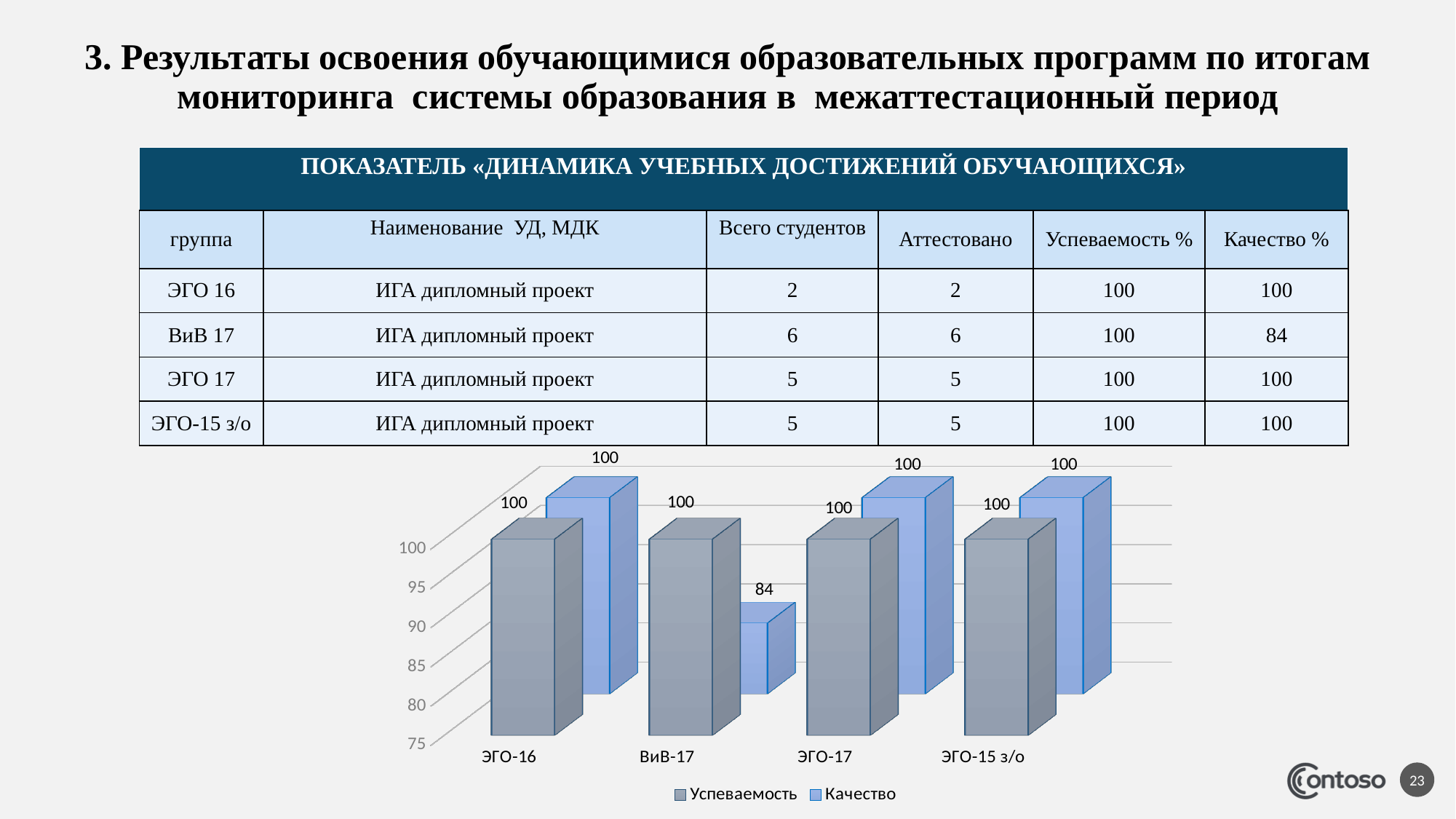
Which group has the lowest Качество value in the chart? ВиВ-17 What is the Успеваемость value for ЭГО-15 з/о in the chart? 100 What is the Качество value for ЭГО-17 in the chart? 100 What is the Успеваемость value for ЭГО-16 in the chart? 100 How many series does the chart legend list? 2 What is the Качество value for ВиВ-17 in the chart? 84 How many groups (categories) are shown on the x axis of the chart? 4 What are the two series names listed in the chart legend? Успеваемость, Качество What is the difference between the Успеваемость and Качество values for ВиВ-17? 16 Is the Качество value for ВиВ-17 greater or less than 90? less Which is larger for ВиВ-17: Успеваемость or Качество? Успеваемость What kind of chart is shown on the slide? bar chart